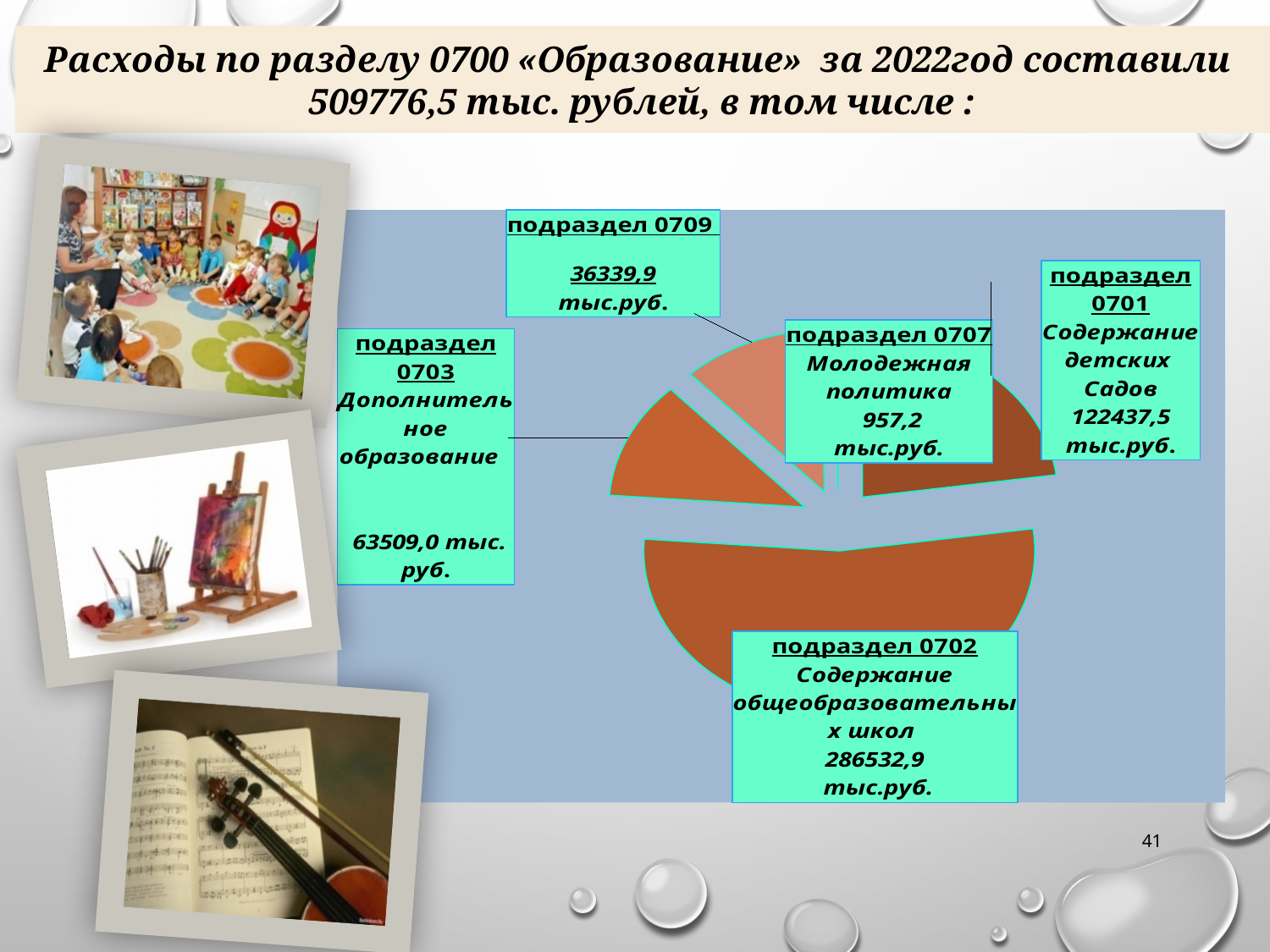
What is the value for подраздел 0701 (Содержание детских садов)? 122437,5 тыс.руб. According to the slide title, what were the total expenditures for раздел 0700 «Образование» in 2022? 509776,5 тыс. рублей What is the value for подраздел 0709? 36339,9 тыс.руб. What is the difference between подраздел 0702 and подраздел 0701? 164095,4 тыс.руб. What is the value for подраздел 0707 (Молодежная политика)? 957,2 тыс.руб. How many subsections (slices) does the pie chart show? 5 What is the value for подраздел 0702 (Содержание общеобразовательных школ)? 286532,9 тыс.руб. What type of chart is shown on the slide? pie chart Which is larger, подраздел 0703 or подраздел 0709? подраздел 0703 What is the value for подраздел 0703 (Дополнительное образование)? 63509,0 тыс. руб. Which subsection has the largest expenditure? подраздел 0702 Which subsection has the smallest expenditure? подраздел 0707